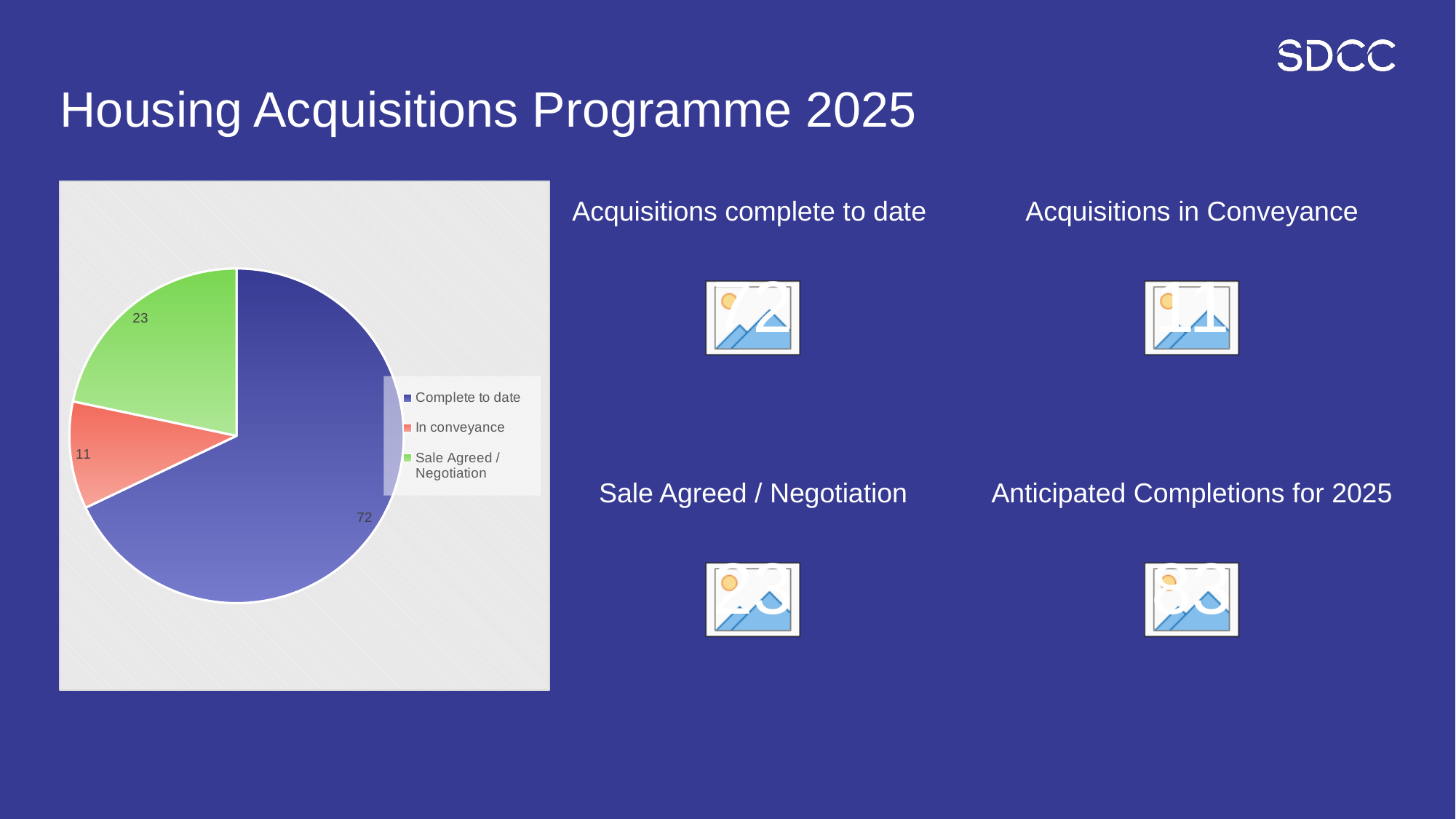
What is the difference between the Complete to date value and the Sale Agreed / Negotiation value? 49 How many slices does the pie chart have? 3 What kind of chart is shown on the slide? Pie chart What is the value for Sale Agreed / Negotiation in the pie chart? 23 What is the value for In conveyance in the pie chart? 11 Which category has the smallest slice in the pie chart? In conveyance Which category has the largest slice in the pie chart? Complete to date What is the difference between the Sale Agreed / Negotiation value and the In conveyance value? 12 What is the value for Complete to date in the pie chart? 72 Which is larger, Sale Agreed / Negotiation or In conveyance? Sale Agreed / Negotiation What colour is the Complete to date slice in the pie chart? Blue What is the total of all the values shown in the pie chart? 106